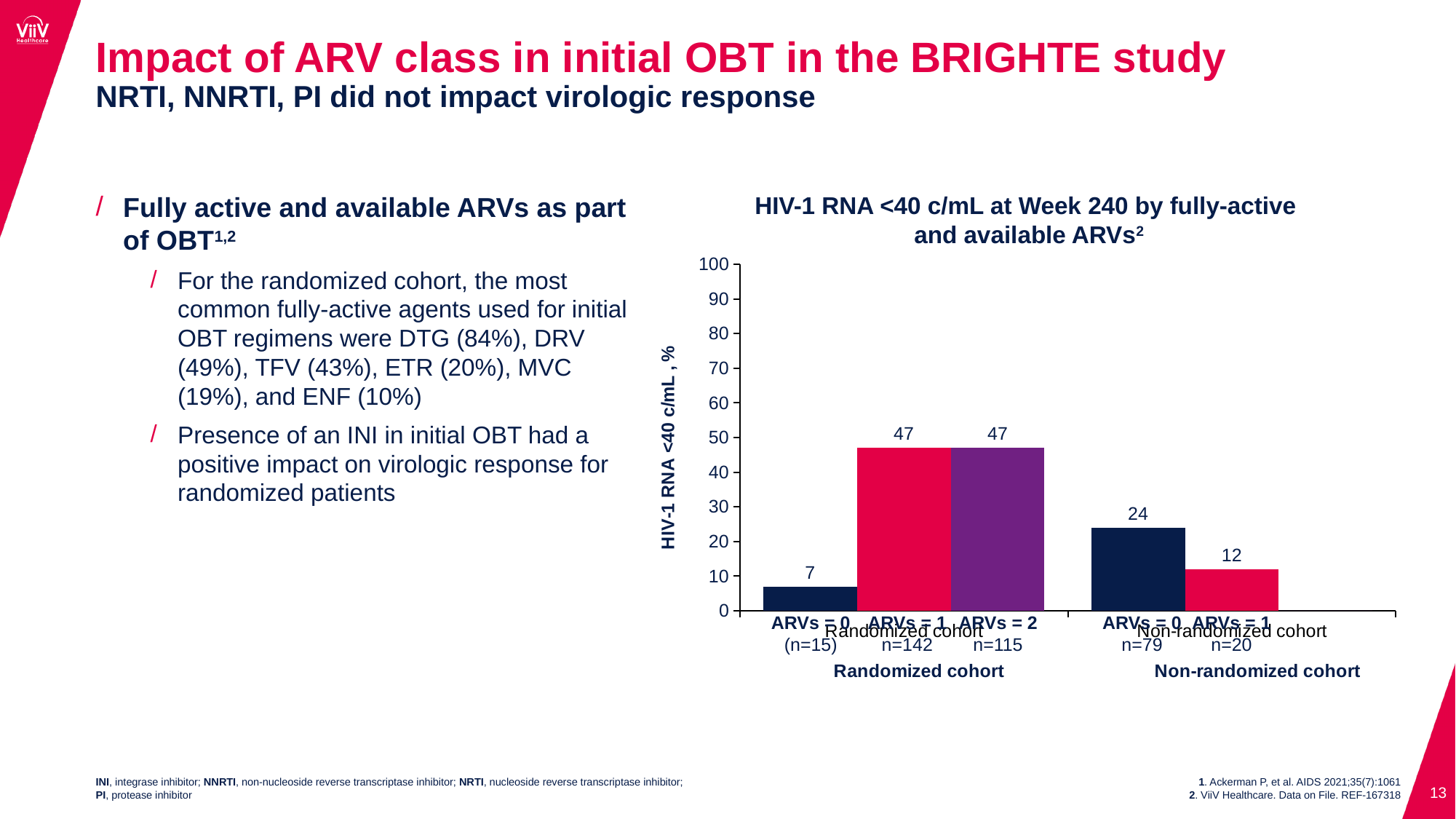
What kind of chart is shown on the slide? Bar chart Which is larger: the value for ARVs = 0 in the randomized cohort or ARVs = 0 in the non-randomized cohort? ARVs = 0 in the non-randomized cohort What is the value for ARVs = 0 in the randomized cohort? 7 What is the value for ARVs = 1 in the non-randomized cohort? 12 What is the value for ARVs = 2 in the randomized cohort? 47 How many bars are plotted in the chart? 5 What is the value for ARVs = 0 in the non-randomized cohort? 24 What is the value for ARVs = 1 in the randomized cohort? 47 What is the difference between the values for ARVs = 0 and ARVs = 1 in the non-randomized cohort? 12 Which bar has the lowest value in the chart? ARVs = 0 (randomized cohort) What is the difference between the values for ARVs = 1 in the randomized cohort and ARVs = 1 in the non-randomized cohort? 35 What is the title of the chart? HIV-1 RNA <40 c/mL at Week 240 by fully-active and available ARVs